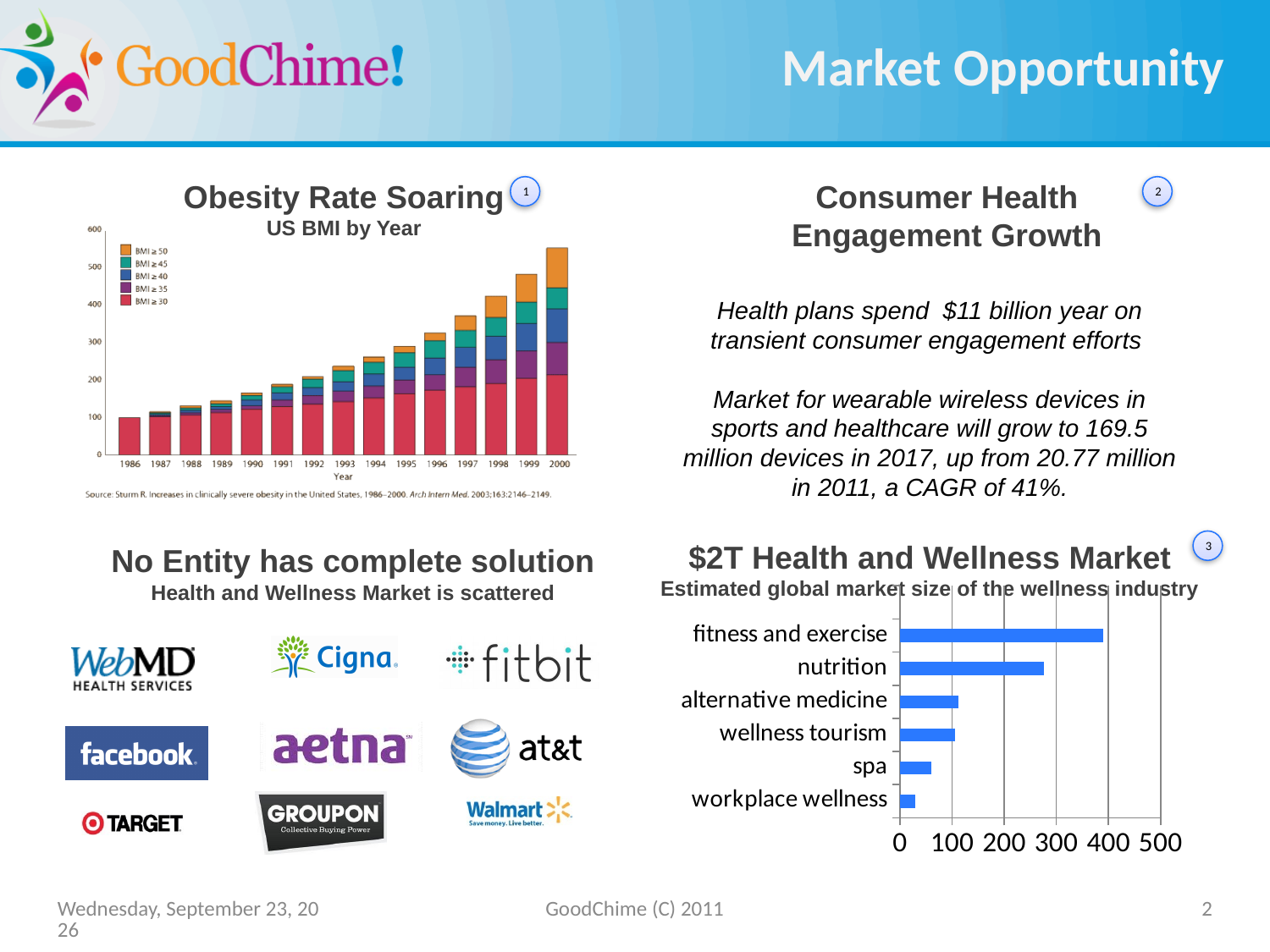
In the 'Obesity Rate Soaring' chart, do the total bar heights rise or fall from 1986 to 2000? rise In the '$2T Health and Wellness Market' chart, is the value for nutrition greater or less than 200? greater How many categories are shown in the '$2T Health and Wellness Market' chart? 6 How many series does the legend of the 'Obesity Rate Soaring' chart list? 5 In the '$2T Health and Wellness Market' chart, which category has the lowest value? workplace wellness In the '$2T Health and Wellness Market' chart, which is larger, nutrition or alternative medicine? nutrition What is the subtitle of the '$2T Health and Wellness Market' chart? Estimated global market size of the wellness industry How many years are shown on the x axis of the 'Obesity Rate Soaring' chart? 15 In the '$2T Health and Wellness Market' chart, which category has the highest value? fitness and exercise In the '$2T Health and Wellness Market' chart, is the value for fitness and exercise greater or less than 300? greater What kind of chart is the '$2T Health and Wellness Market' chart? bar chart In the '$2T Health and Wellness Market' chart, is the value for spa greater or less than 100? less